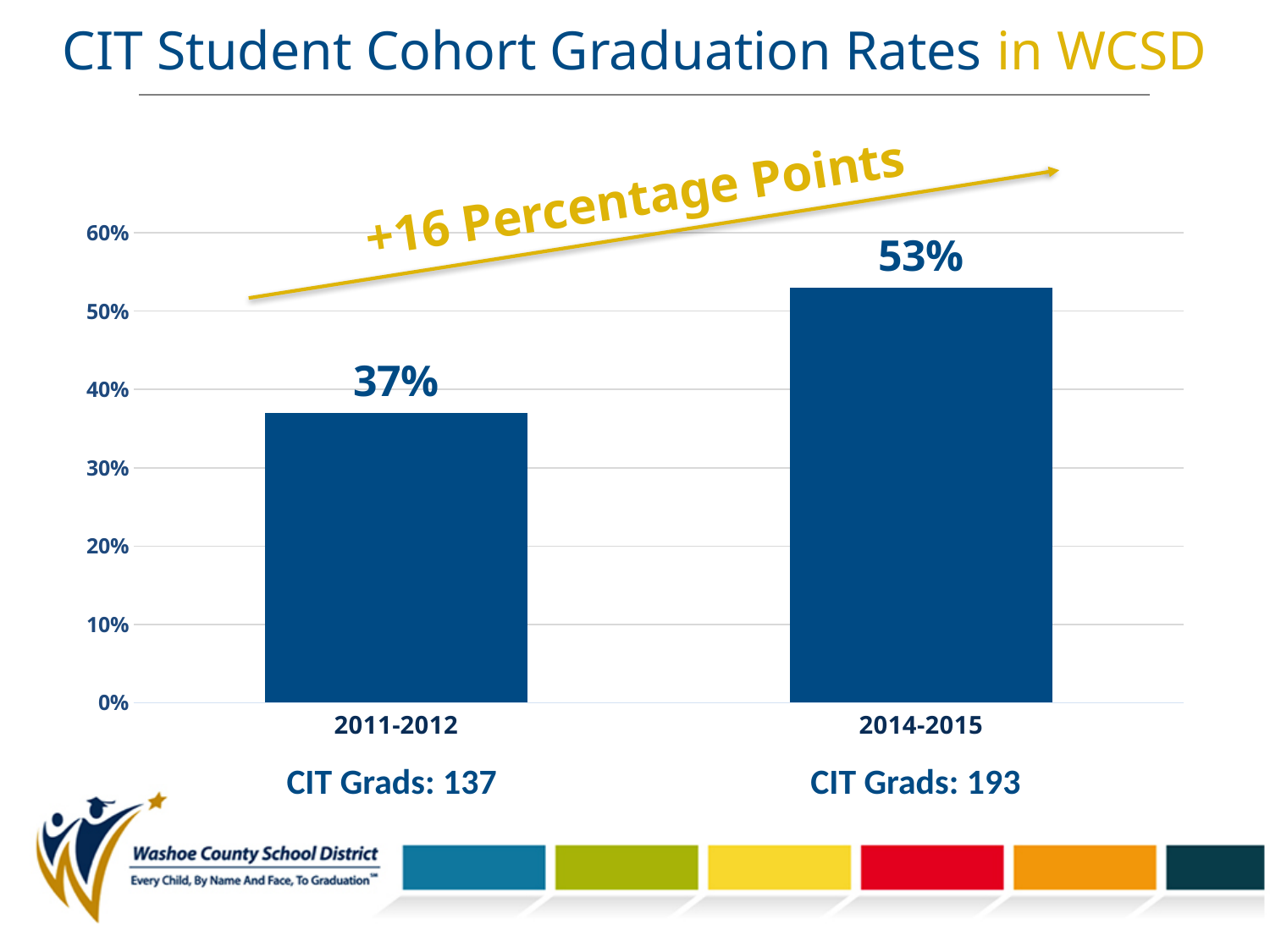
Do the graduation rates rise or fall from 2011-2012 to 2014-2015? Rise How many cohorts are shown in the chart? 2 Is the graduation rate for 2014-2015 greater or less than 50%? greater What is the difference in graduation rate between the 2014-2015 and 2011-2012 cohorts? 16 percentage points Which cohort has the lower graduation rate? 2011-2012 What is the title of the chart? CIT Student Cohort Graduation Rates in WCSD What is the graduation rate for the 2014-2015 cohort? 53% Is the graduation rate for 2011-2012 greater or less than 40%? less Which cohort has the higher graduation rate? 2014-2015 What is the graduation rate for the 2011-2012 cohort? 37% What kind of chart is shown on the slide? Bar chart How many CIT grads are listed for the 2014-2015 cohort? 193